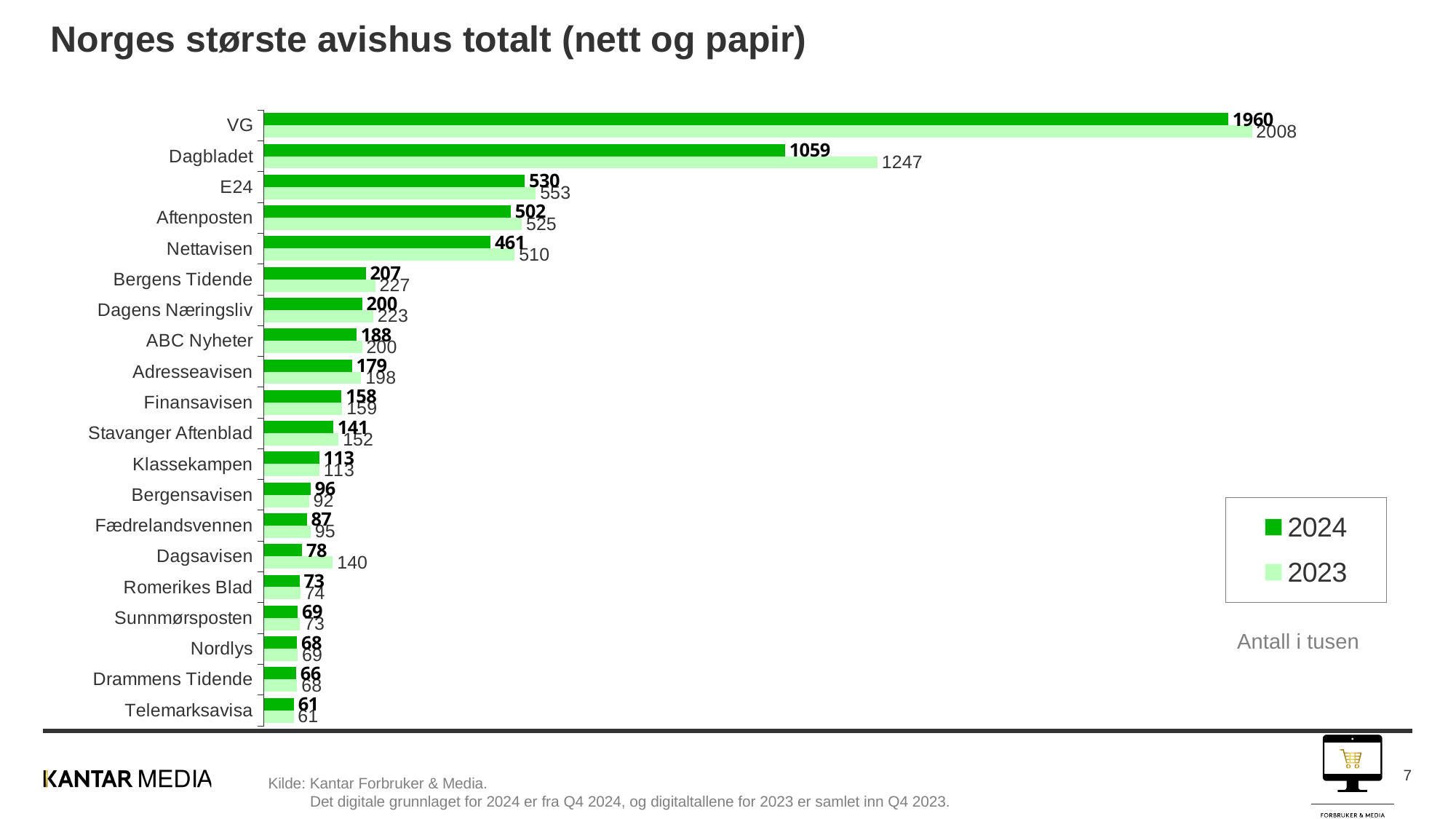
Which newspaper has the lowest 2023 value? Telemarksavisa Which newspaper has the highest 2024 value? VG What is the difference between the 2023 and 2024 values for VG? 48 Which is larger for Bergensavisen, the 2024 value or the 2023 value? 2024 How many newspapers are listed on the chart? 20 What is the 2023 value for Nettavisen? 510 What is the 2024 value for Dagbladet? 1059 What is the 2024 value for Stavanger Aftenblad? 141 How many series does the legend list? 2 What kind of chart is shown on the slide? Bar chart What is the difference between the 2023 and 2024 values for Dagsavisen? 62 Which is larger, the 2024 value for E24 or the 2024 value for Aftenposten? E24